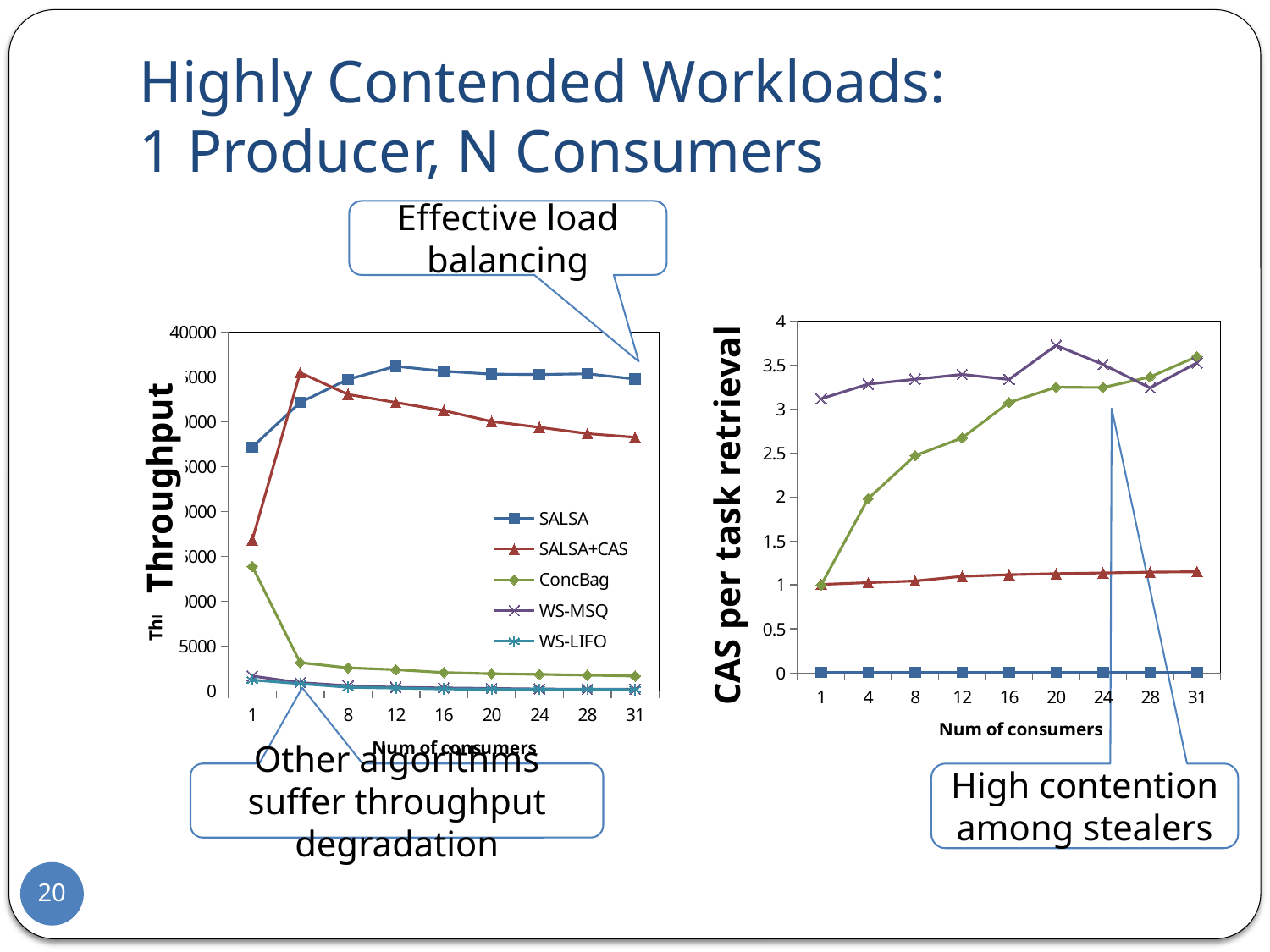
What kind of chart is the left chart titled Throughput? line chart How many points along the Num of consumers axis does the left Throughput chart plot for each series? 9 In the left Throughput chart, does the ConcBag series rise or fall as the number of consumers increases? fall What is the y-axis label of the right chart? CAS per task retrieval In the left Throughput chart, which series has the highest throughput at 1 consumer? SALSA In the left Throughput chart, which series has the highest throughput at 12 consumers? SALSA In the right CAS per task retrieval chart, is the value of the green diamond-marker series at 31 consumers greater or less than 3? greater In the left Throughput chart, which is larger at 31 consumers: SALSA or SALSA+CAS? SALSA In the left Throughput chart, is the value for ConcBag at 31 consumers greater or less than 5000? less In the right CAS per task retrieval chart, does the green diamond-marker series rise or fall as the number of consumers increases? rise How many series does the legend of the left Throughput chart list? 5 In the left Throughput chart, is the value for ConcBag at 1 consumer greater or less than 5000? greater